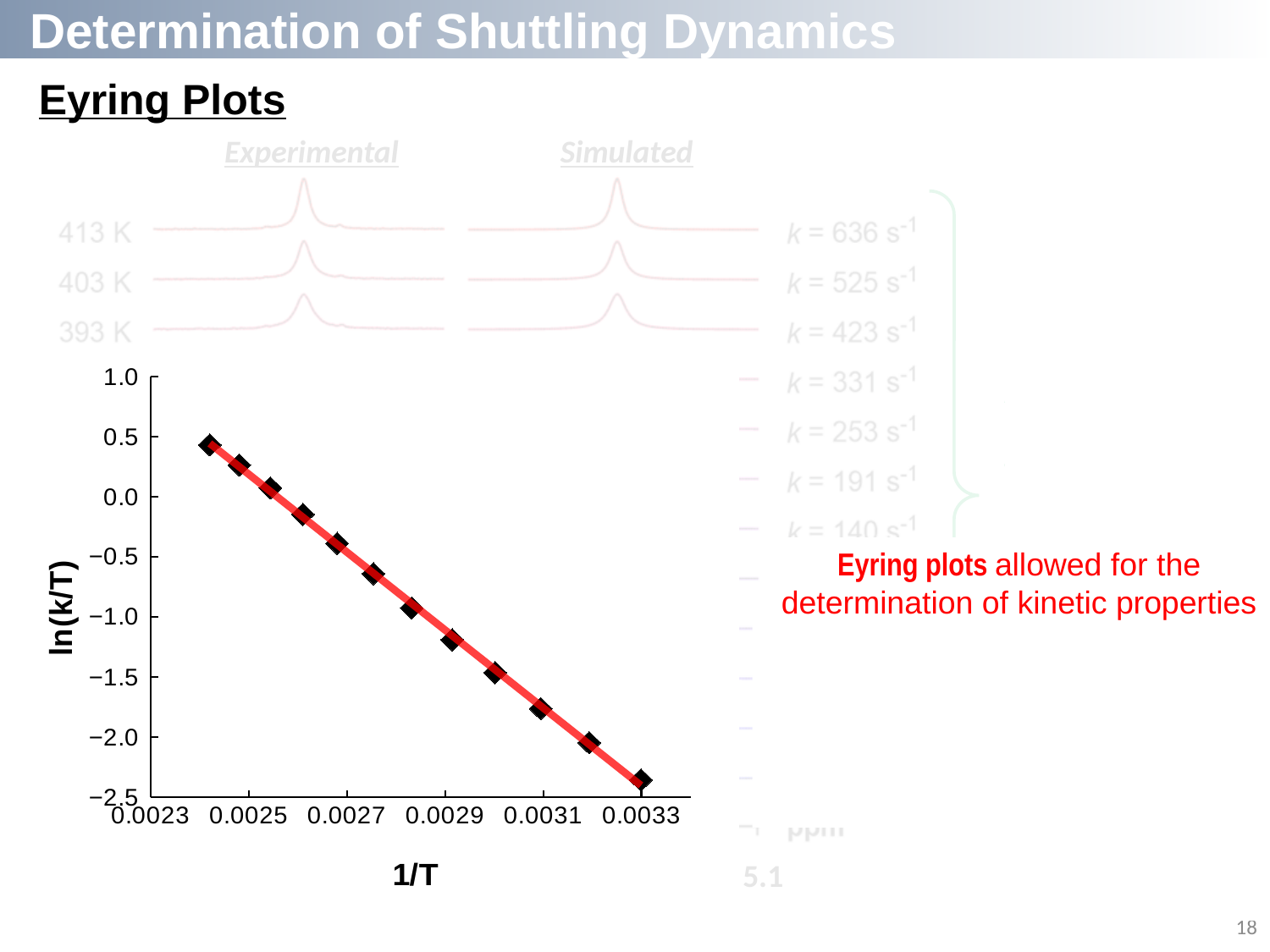
What kind of chart is the Eyring plot on the slide? Scatter plot with a fitted line What is the lowest value shown on the y axis of the Eyring plot? −2.5 Is the ln(k/T) value of the data point near 1/T = 0.0024 greater or less than 0.0? greater Is the ln(k/T) value of the data point near 1/T = 0.0033 greater or less than −2.0? less Is the ln(k/T) value of the data point near 1/T = 0.0025 greater or less than 0.5? less At which end of the x axis does the highest ln(k/T) value occur, the low-1/T end or the high-1/T end? The low-1/T end How many data points are plotted on the Eyring plot? 12 What is the label of the y axis of the Eyring plot? ln(k/T) Do the ln(k/T) values rise or fall as 1/T increases along the x axis? Fall What is the label of the x axis of the Eyring plot? 1/T Which has the larger ln(k/T) value: the leftmost data point or the rightmost data point? The leftmost data point